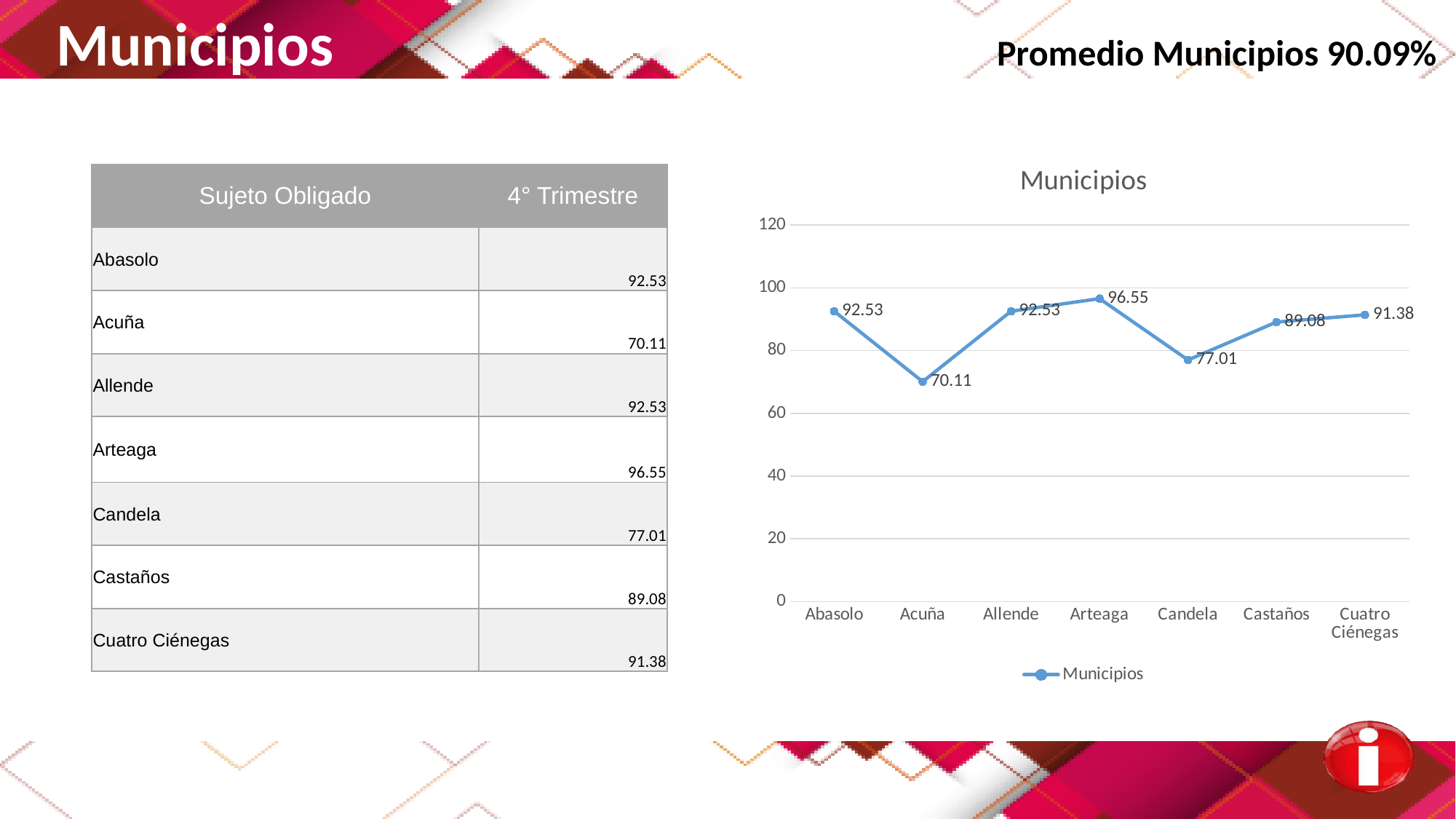
Which is larger in the Municipios chart, the value for Candela or the value for Castaños? Castaños What is the difference between the values for Arteaga and Acuña in the Municipios chart? 26.44 Which municipality has the lowest value in the Municipios chart? Acuña Which municipality has the highest value in the Municipios chart? Arteaga What is the value for Acuña in the Municipios chart? 70.11 What is the value for Cuatro Ciénegas in the Municipios chart? 91.38 How many municipalities are plotted on the x axis of the Municipios chart? 7 What is the value for Arteaga in the Municipios chart? 96.55 What kind of chart is the Municipios chart? line chart What is the difference between the values for Castaños and Candela in the Municipios chart? 12.07 Is the value for Candela in the Municipios chart greater or less than 80? less How many series does the legend of the Municipios chart list? 1